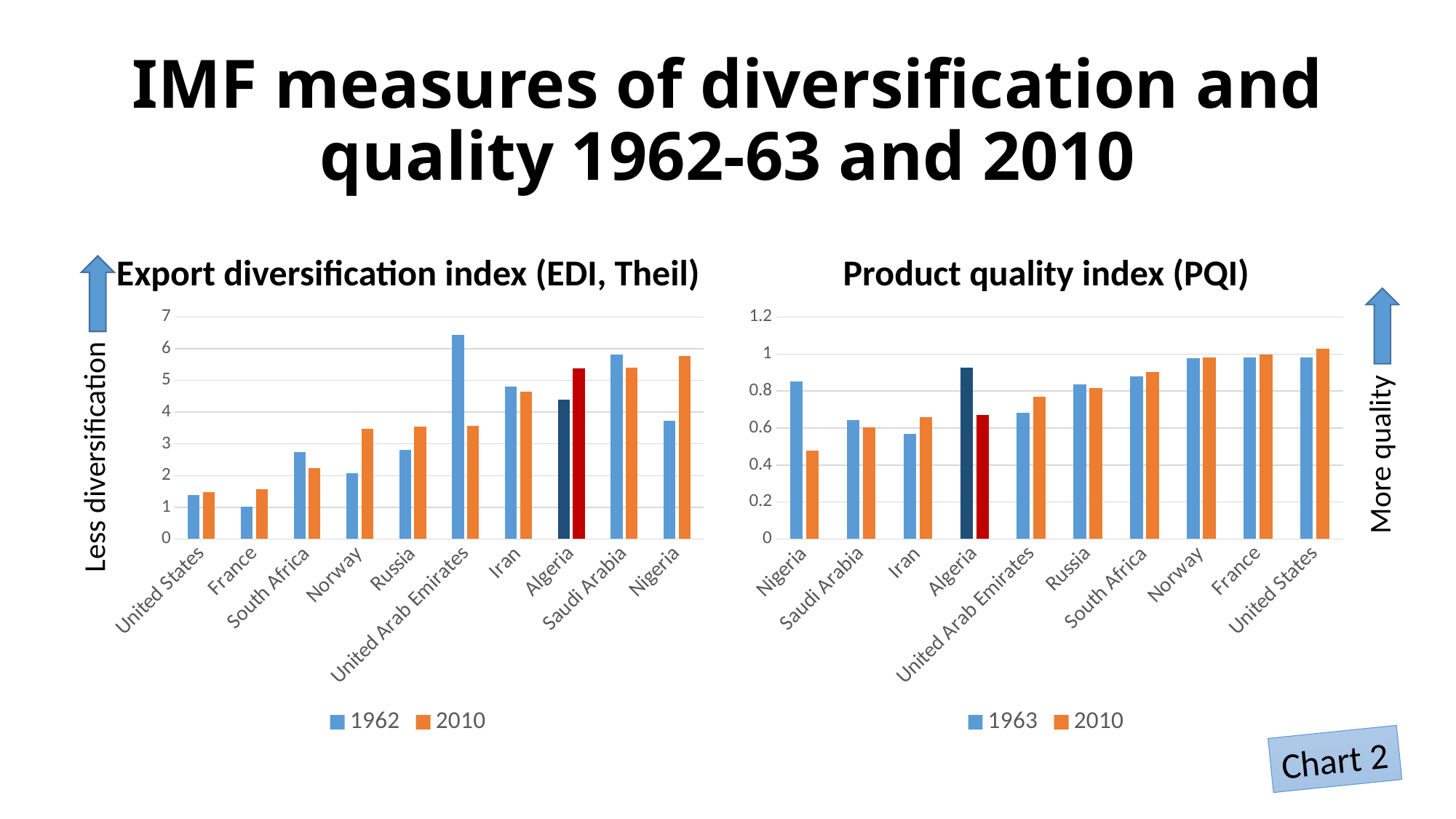
On the Product quality index (PQI) chart, which country has the lowest 2010 value? Nigeria On the Export diversification index (EDI, Theil) chart, which country has the highest 1962 value? United Arab Emirates On the Product quality index (PQI) chart, which is larger for Nigeria, the 1963 value or the 2010 value? 1963 On the Export diversification index (EDI, Theil) chart, is the 1962 value for United Arab Emirates greater or less than 6? greater On the Product quality index (PQI) chart, which country has the highest 2010 value? United States On the Product quality index (PQI) chart, is the 2010 value for Nigeria greater or less than 0.6? less What kind of chart is the Export diversification index (EDI, Theil) chart? bar chart On the Export diversification index (EDI, Theil) chart, is the 1962 value for Nigeria greater or less than 4? less How many series does the legend of the Product quality index (PQI) chart list? 2 On the Product quality index (PQI) chart, which is larger for Iran, the 1963 value or the 2010 value? 2010 How many countries are shown on the Export diversification index (EDI, Theil) chart? 10 On the Export diversification index (EDI, Theil) chart, which country has the highest 2010 value? Nigeria